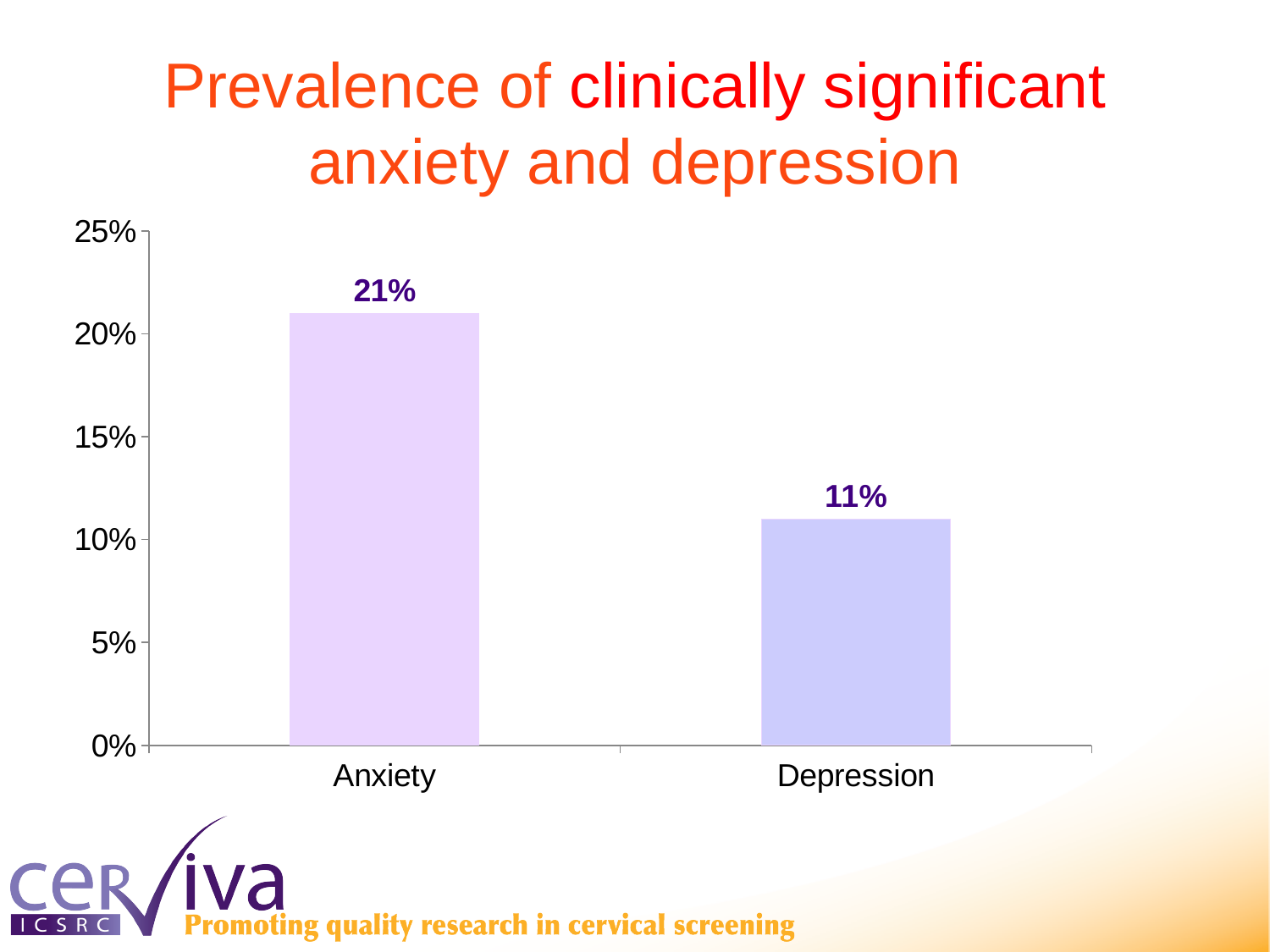
What is the prevalence value shown for Anxiety? 21% What is the maximum value shown on the y axis? 25% Which is larger, the value for Anxiety or the value for Depression? Anxiety How many categories are shown on the x axis? 2 Which category has the lowest value? Depression Which category has the highest value? Anxiety Is the value for Depression greater or less than 15%? less What is the prevalence value shown for Depression? 11% Is the value for Anxiety greater or less than 20%? greater What is the difference between the values for Anxiety and Depression? 10% What kind of chart is shown on the slide? Bar chart What is the title of the slide? Prevalence of clinically significant anxiety and depression